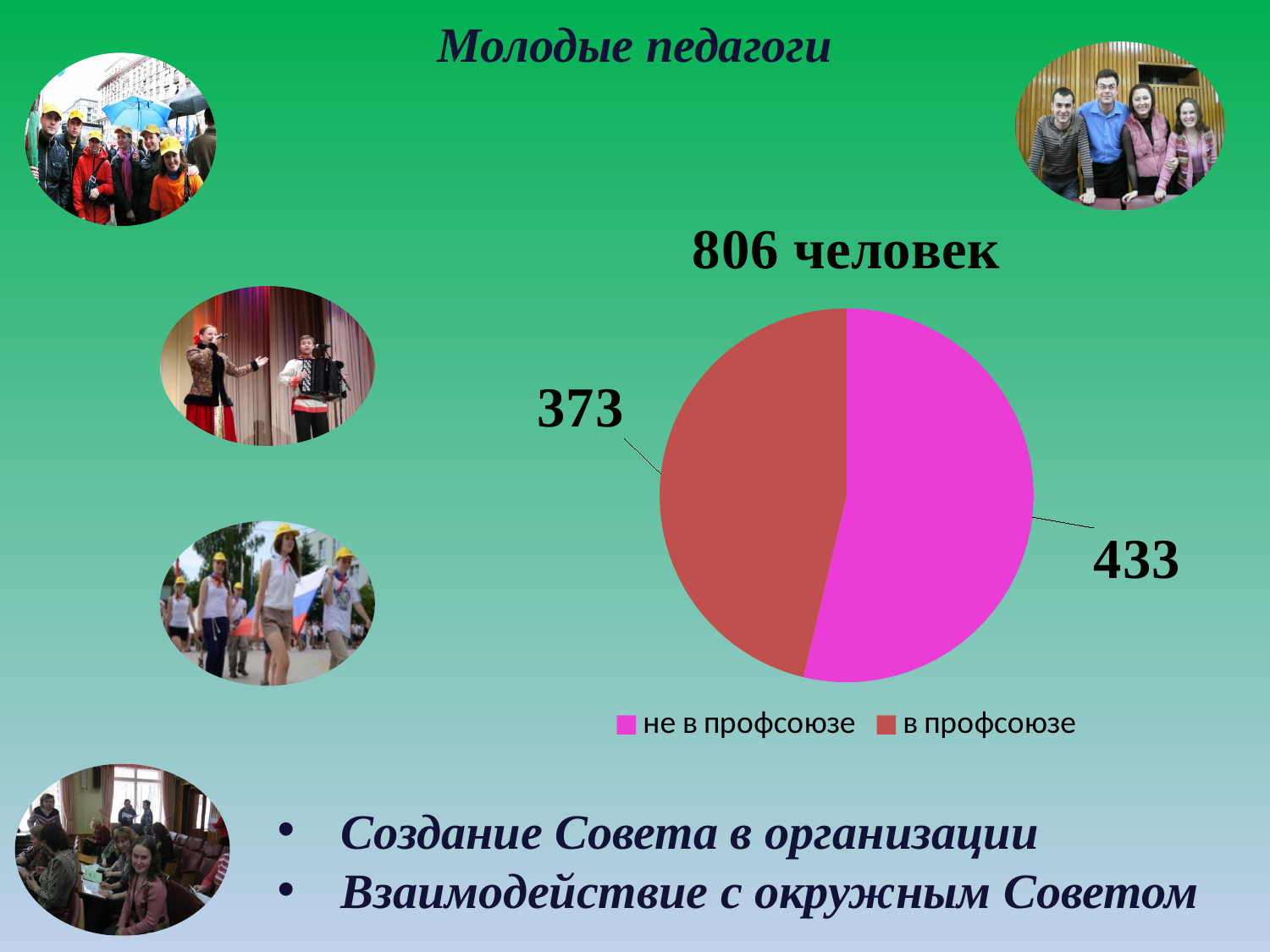
What is the value for "не в профсоюзе" in the pie chart? 433 What is the title shown above the pie chart? 806 человек Which slice of the pie chart is the largest? не в профсоюзе How many entries does the legend of the pie chart list? 2 What is the total of the two values shown in the pie chart? 806 What is the value for "в профсоюзе" in the pie chart? 373 Which slice of the pie chart is the smallest? в профсоюзе What is the difference between the values for "не в профсоюзе" and "в профсоюзе"? 60 How many slices does the pie chart have? 2 Which colour represents "в профсоюзе" in the pie chart? red-brown Which is larger: the value for "в профсоюзе" or the value for "не в профсоюзе"? не в профсоюзе What kind of chart is shown on the slide? pie chart